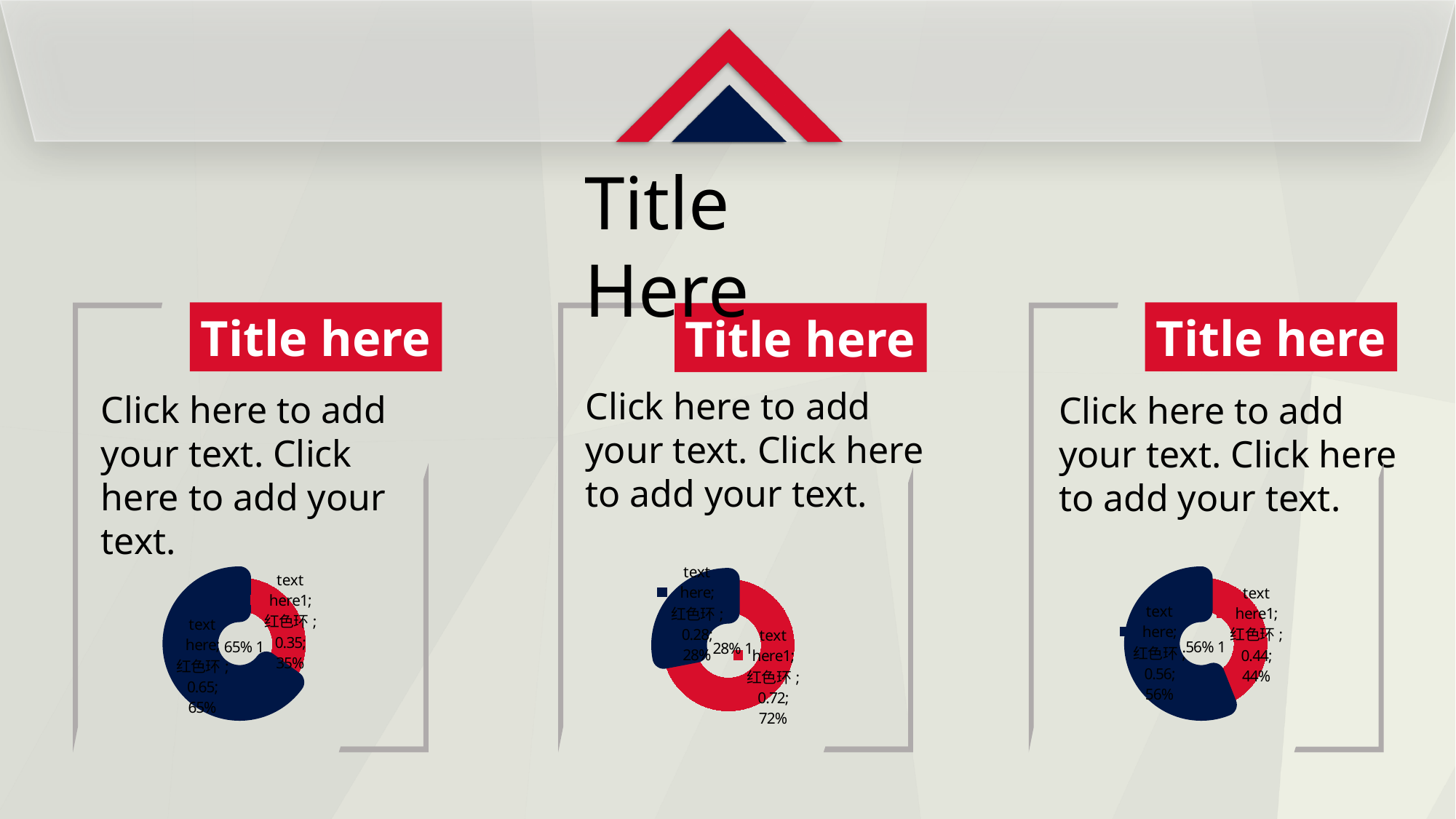
In the right chart, what is the value shown for the 'text here' slice? 56% In the right chart, which slice is the smallest? text here1 In the middle chart, what is the value shown for the 'text here' slice? 28% In the middle chart, which slice is the largest? text here1 In the left chart, which slice is the largest? text here In the left chart, what is the difference between the 'text here' and 'text here1' values? 30 percentage points In the left chart, what is the value shown for the 'text here1' slice? 35% In the left chart, what is the value shown for the 'text here' slice? 65% What kind of chart is shown in each of the three panels? Pie (donut) chart In the middle chart, what is the value shown for the 'text here1' slice? 72% In the right chart, what is the value shown for the 'text here1' slice? 44%